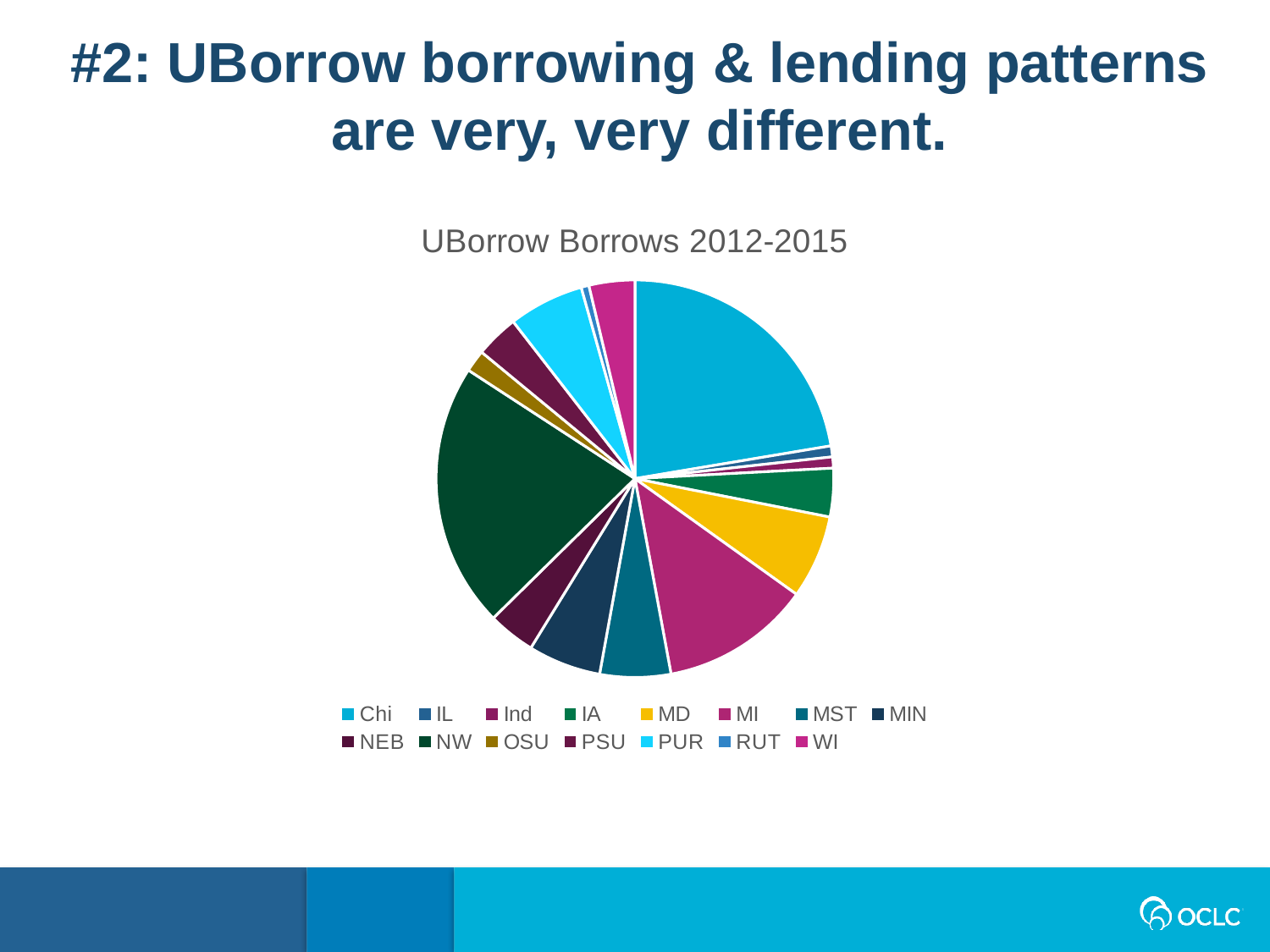
Which slice is larger, NW or PSU? NW Which slice is larger, MI or OSU? MI Which slice is larger, PUR or WI? PUR How many data series does the pie chart plot? 1 What is the title of the chart? UBorrow Borrows 2012-2015 How many categories (slices) does the legend list for the pie chart? 15 Which legend entry is listed first in the pie chart's legend? Chi What kind of chart is shown on the slide? pie chart